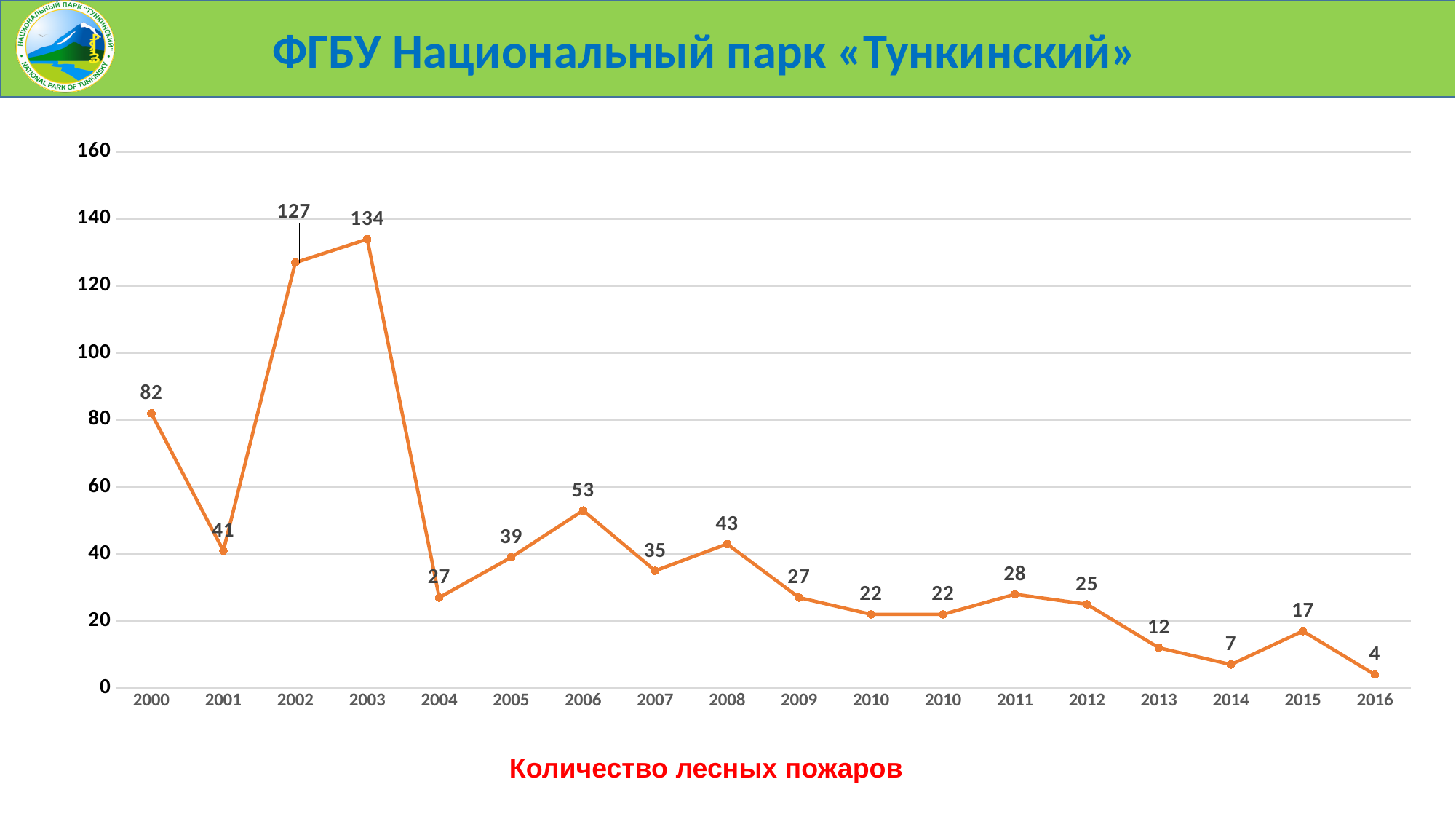
Which is larger, the value for 2005 or the value for 2007? 2005 How many data points are plotted on the chart? 18 Which year has the highest value? 2003 What is the value for 2006? 53 Which year has the lowest value? 2016 What is the difference between the values for 2003 and 2002? 7 What is the difference between the values for 2000 and 2001? 41 What is the caption shown below the chart? Количество лесных пожаров What is the value for 2000? 82 What is the value for 2016? 4 What is the number of forest fires in 2003? 134 What kind of chart is shown on the slide? line chart